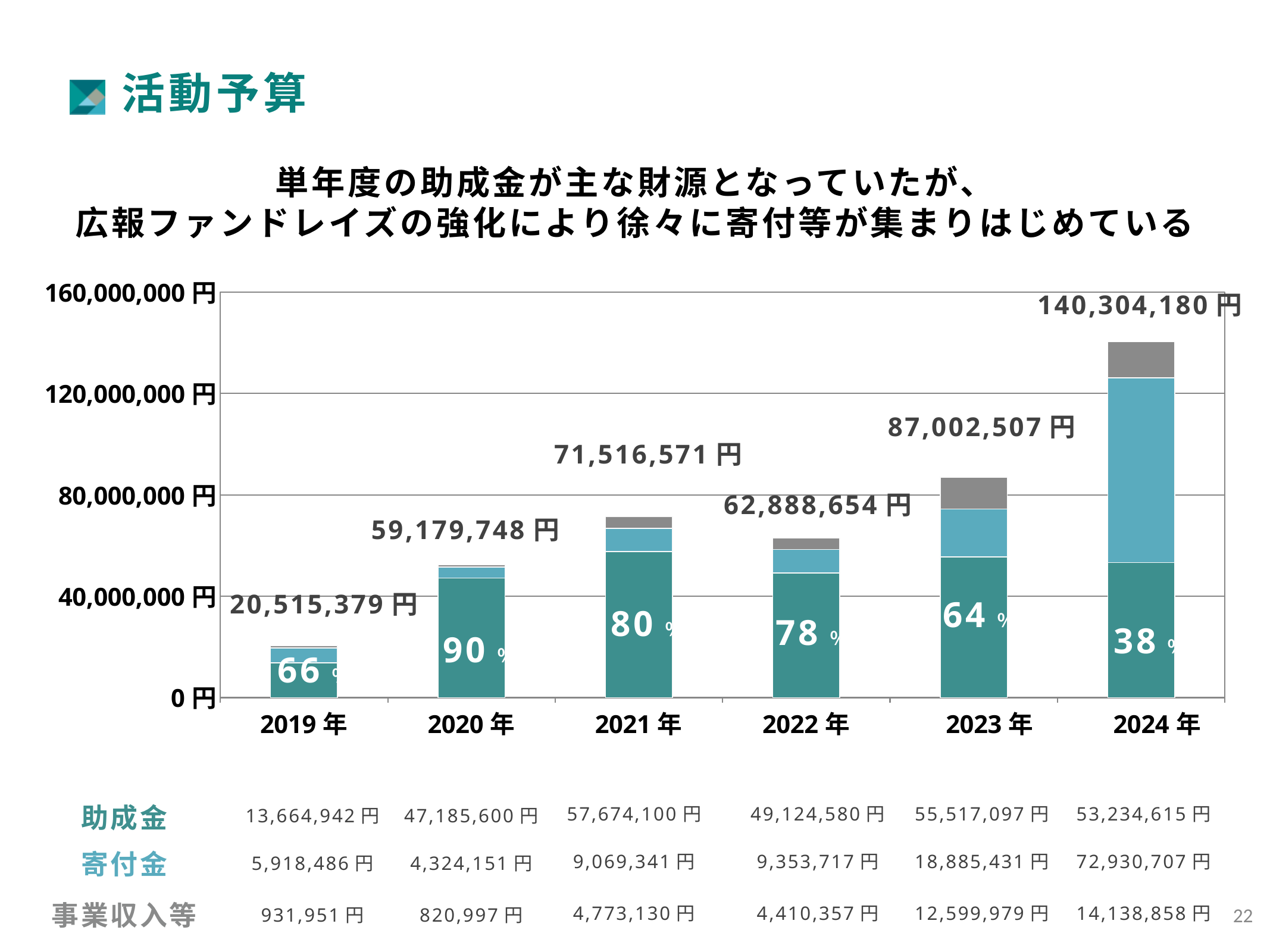
Which year has the larger total, 2021 年 or 2022 年? 2021 年 What is the difference between the total for 2024 年 and the total for 2023 年? 53,301,673 円 Which year has the lowest total value? 2019 年 What is the total value labeled above the bar for 2024 年? 140,304,180 円 What kind of chart is shown on the slide? bar chart What percentage is printed inside the bar for 2023 年? 64% What is the 寄付金 value for 2024 年? 72,930,707 円 How many income series (rows in the table below the chart) are stacked in each bar? 3 How many years are shown on the x axis of the chart? 6 Which year has the highest total value? 2024 年 Is the total value for 2020 年 greater or less than 40,000,000 円? greater What is the 助成金 value for 2021 年? 57,674,100 円